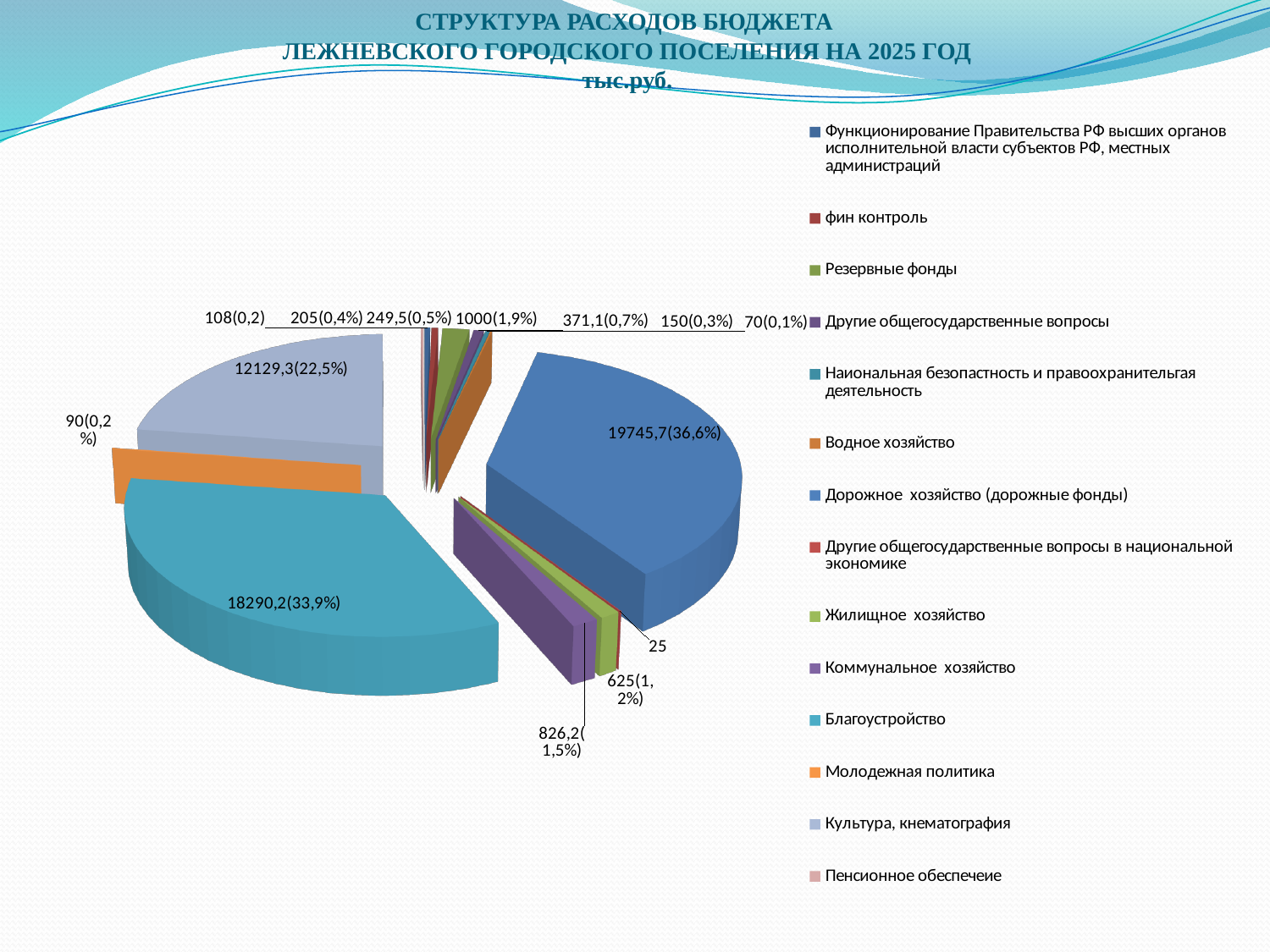
What value is labelled on the slice for Коммунальное хозяйство? 826,2(1,5%) What value is labelled on the slice for Культура, кнематография? 12129,3(22,5%) Which is larger, the slice for Дорожное хозяйство (дорожные фонды) or the slice for Благоустройство? Дорожное хозяйство (дорожные фонды) What value is labelled on the slice for Дорожное хозяйство (дорожные фонды)? 19745,7(36,6%) What value is labelled on the slice for Благоустройство? 18290,2(33,9%) How many categories does the legend of the pie chart list? 14 What kind of chart is shown on the slide? pie chart What is the smallest value labelled on the pie chart? 25 What is the difference between the values for Дорожное хозяйство (дорожные фонды) and Благоустройство? 1455,5 In what units are the values on the chart expressed, according to the title? тыс.руб. What share of the pie does Дорожное хозяйство (дорожные фонды) account for? 36,6% Which category has the largest slice of the pie chart? Дорожное хозяйство (дорожные фонды)